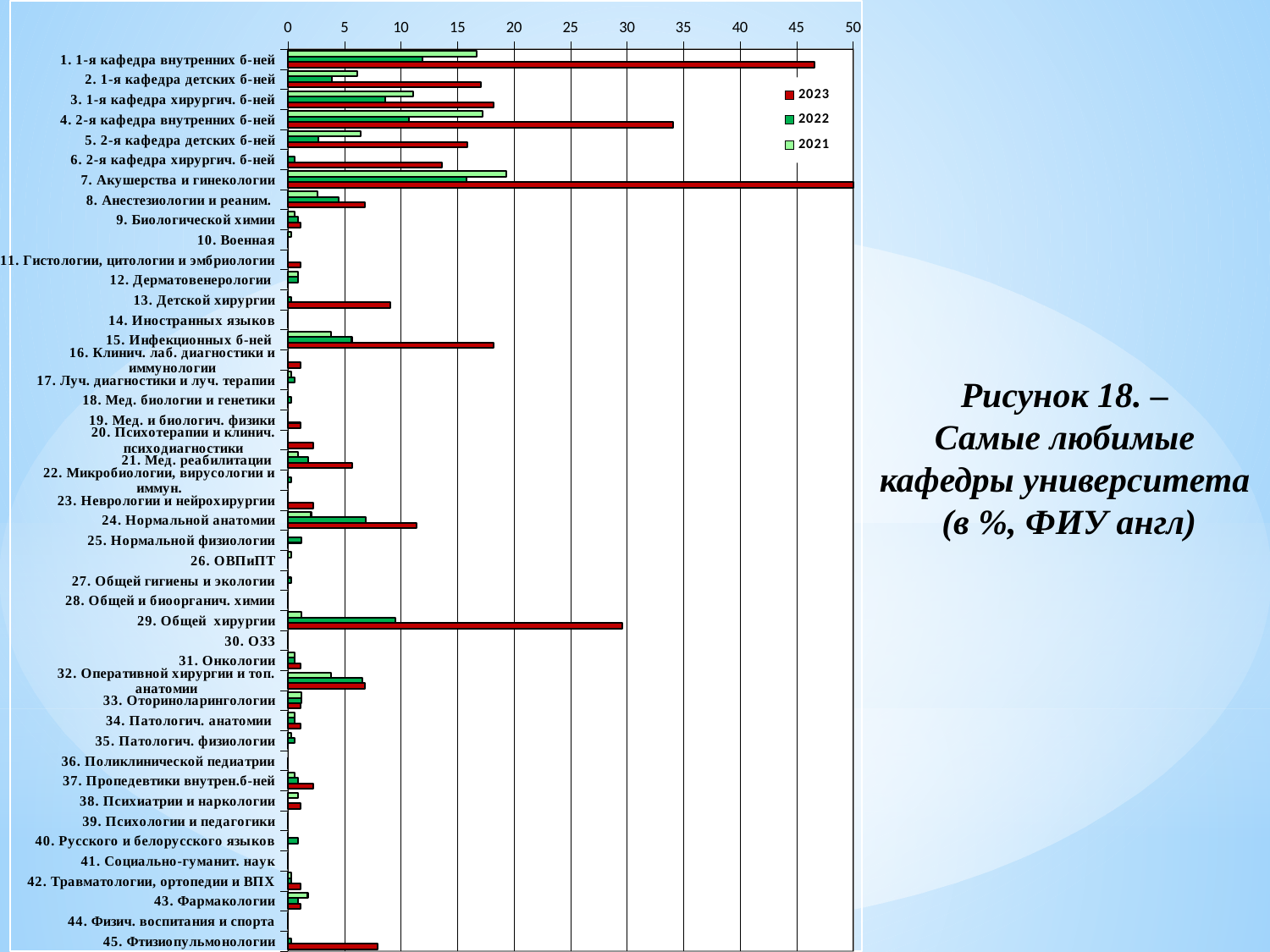
Which department has the highest 2023 value? 7. Акушерства и гинекологии Which year is shown in red in the legend? 2023 How many departments (categories) are listed on the chart? 45 Is the 2023 value for '4. 2-я кафедра внутренних б-ней' greater or less than 30? greater Is the 2023 value for '45. Фтизиопульмонологии' greater or less than 10? less Which department has the larger 2023 value: '1. 1-я кафедра внутренних б-ней' or '4. 2-я кафедра внутренних б-ней'? 1. 1-я кафедра внутренних б-ней Is the 2023 value for '29. Общей хирургии' greater or less than 25? greater Which is larger for '24. Нормальной анатомии': the 2023 value or the 2022 value? 2023 How many series does the legend list? 3 Which department has the highest 2021 value? 7. Акушерства и гинекологии What kind of chart is shown on the slide? bar chart